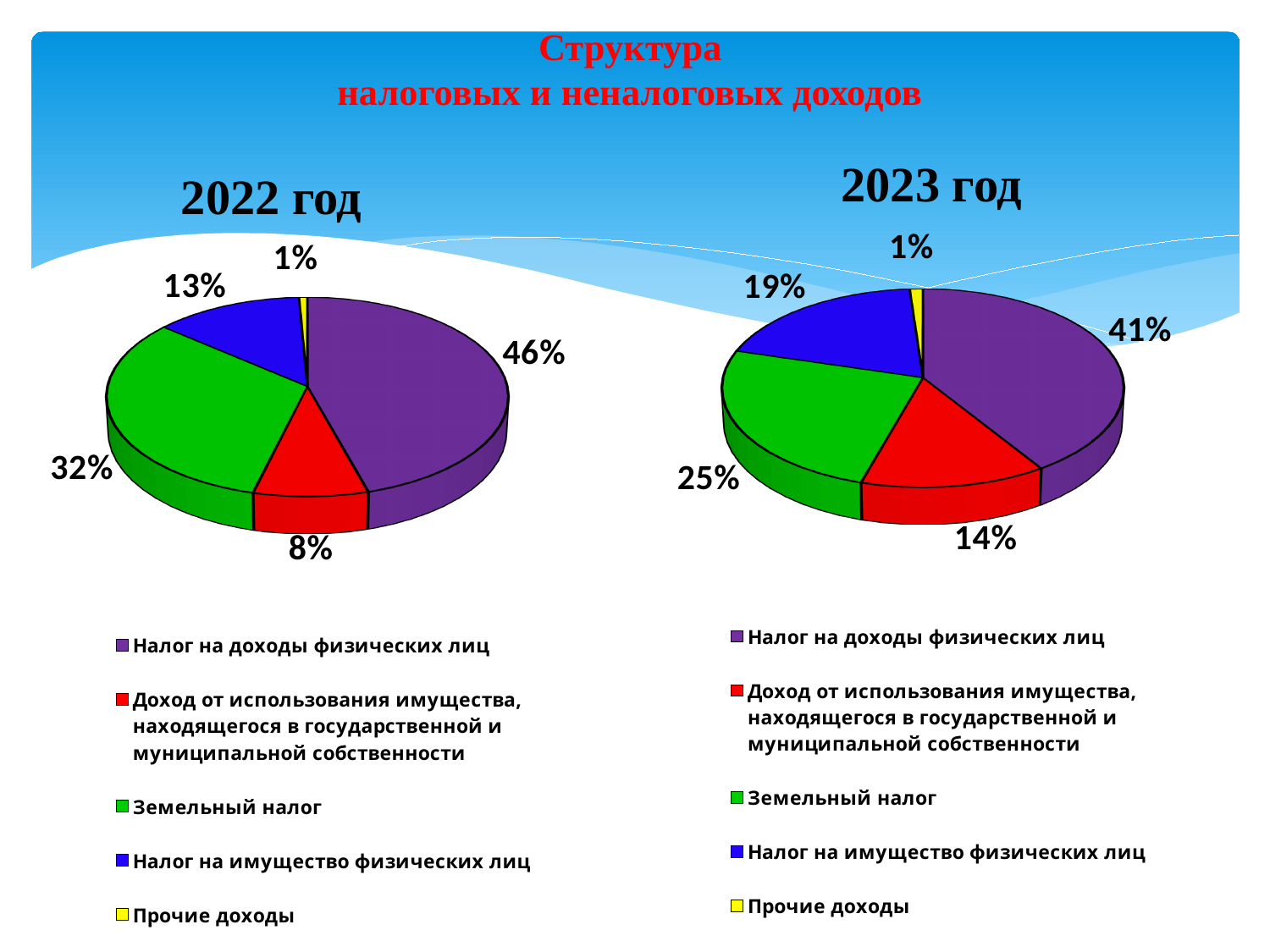
What type of chart is used for 2022 год? Pie chart In the 2023 год chart, which colour represents Прочие доходы? Yellow In the 2022 год chart, what is the combined share of Земельный налог and Налог на имущество физических лиц? 45% In the 2022 год chart, what share does Доход от использования имущества, находящегося в государственной и муниципальной собственности have? 8% In the 2023 год chart, what share does Земельный налог have? 25% How many slices does the 2023 год pie chart have? 5 Which is larger: the share of Налог на имущество физических лиц in the 2022 год chart or in the 2023 год chart? 2023 год What is the difference between the share of Земельный налог in the 2022 год chart and in the 2023 год chart? 7% In the 2023 год chart, what share does Налог на имущество физических лиц have? 19% In the 2022 год chart, what share does Налог на доходы физических лиц have? 46% In the 2023 год chart, which category has the smallest slice? Прочие доходы In the 2022 год chart, which category has the largest slice? Налог на доходы физических лиц